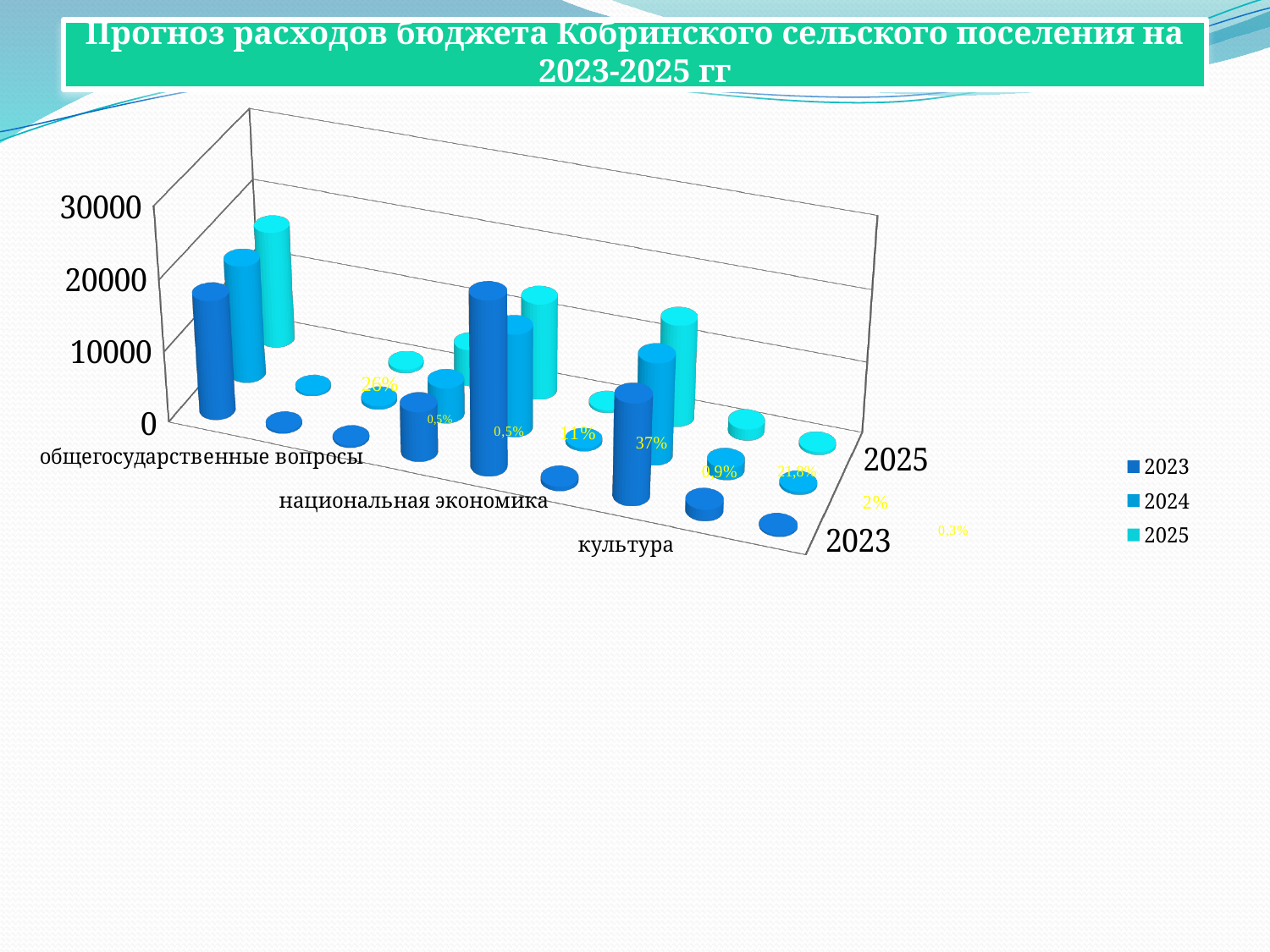
Is the 2023 value for национальная экономика greater or less than 10000? less Is the 2023 value for национальная экономика greater or less than 30000? less Is the 2023 value for культура greater or less than 10000? greater How many series does the legend list? 3 What is the title of the chart on the slide? Прогноз расходов бюджета Кобринского сельского поселения на 2023-2025 гг For 2023, which is larger: национальная экономика or культура? культура Which years are listed in the chart legend? 2023, 2024, 2025 What kind of chart is shown on the slide? bar chart